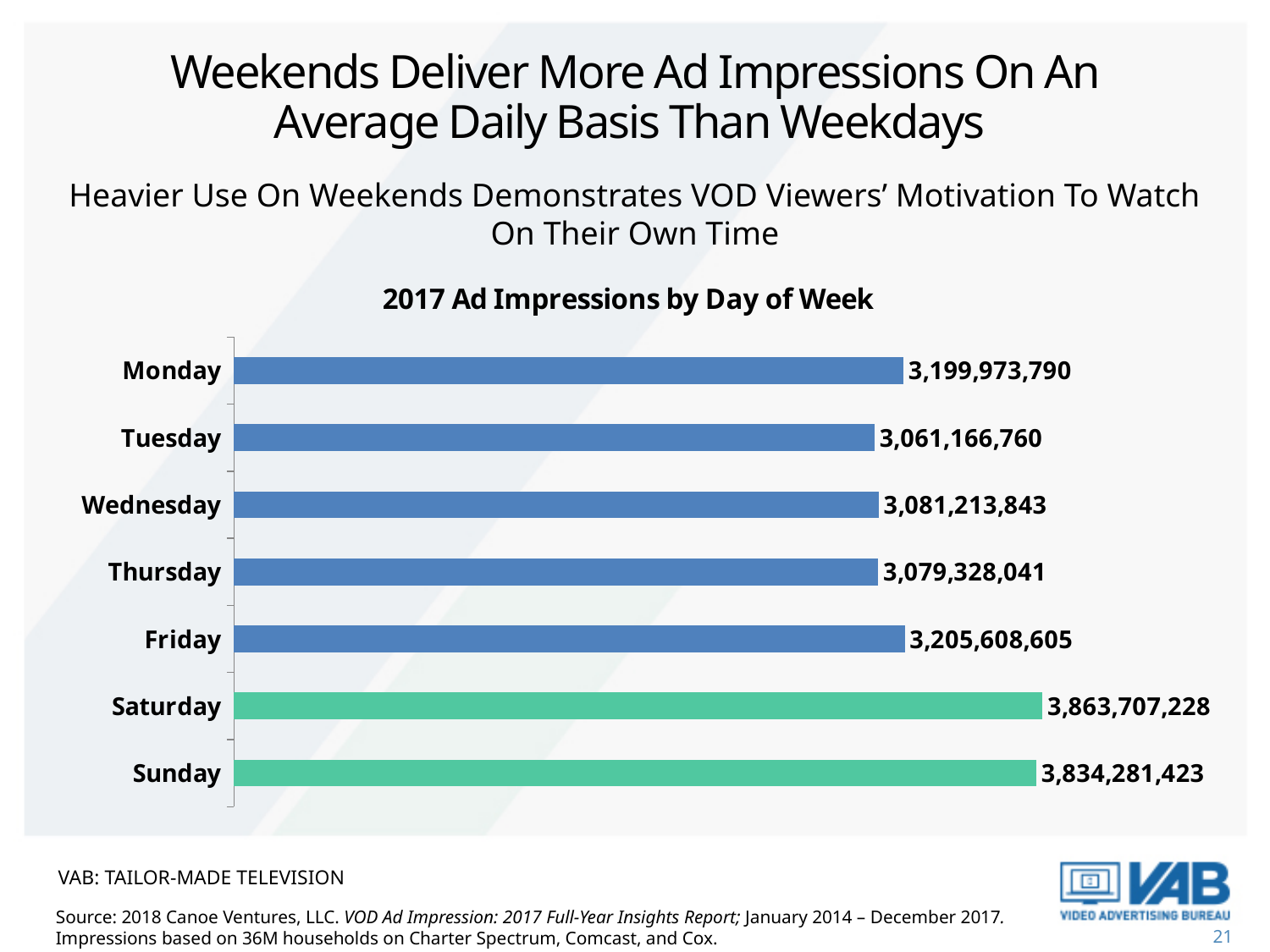
What is the difference between the values for Friday and Monday? 5,634,815 What is the value for Saturday? 3,863,707,228 What is the value for Monday in the 2017 Ad Impressions by Day of Week chart? 3,199,973,790 What kind of chart is shown on the slide? Bar chart How many days of the week are shown in the chart? 7 Which is larger, the value for Friday or the value for Thursday? Friday What is the value for Wednesday? 3,081,213,843 Which days' bars are coloured green rather than blue? Saturday and Sunday Which day of the week has the highest number of ad impressions? Saturday What is the value for Sunday? 3,834,281,423 Which day of the week has the lowest number of ad impressions? Tuesday What is the difference between the values for Saturday and Sunday? 29,425,805